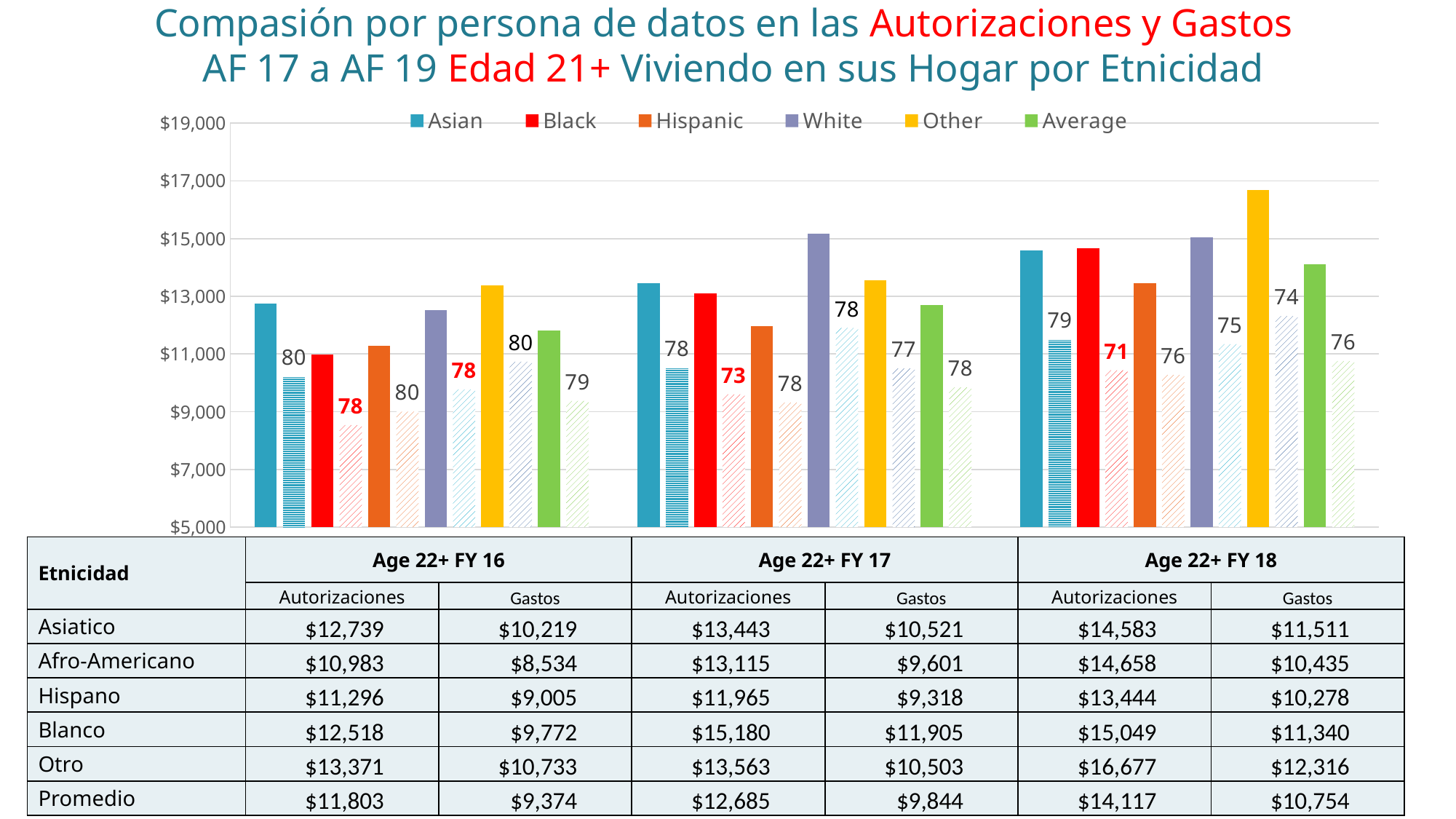
What is the difference between the Autorizaciones and Gastos values for Blanco in Age 22+ FY 17? $3,275 What kind of chart is shown on the slide? bar chart According to the table, what is the Autorizaciones value for Asiatico in Age 22+ FY 16? $12,739 Does the Promedio Autorizaciones value rise or fall from FY 16 to FY 18? rise How many fiscal year groups are shown along the x axis of the chart? 3 What data label is printed on the Black Gastos bar in the FY 18 group? 71 How many series does the chart legend list? 6 In Age 22+ FY 17, which has the larger Autorizaciones value: Asiatico or Afro-Americano? Asiatico Which ethnicity has the highest Autorizaciones value in Age 22+ FY 18? Otro Which ethnicity has the lowest Gastos value in Age 22+ FY 16? Afro-Americano Is the Other (yellow) Autorizaciones bar in the FY 18 group greater or less than $15,000? greater According to the table, what is the Gastos value for Otro in Age 22+ FY 18? $12,316